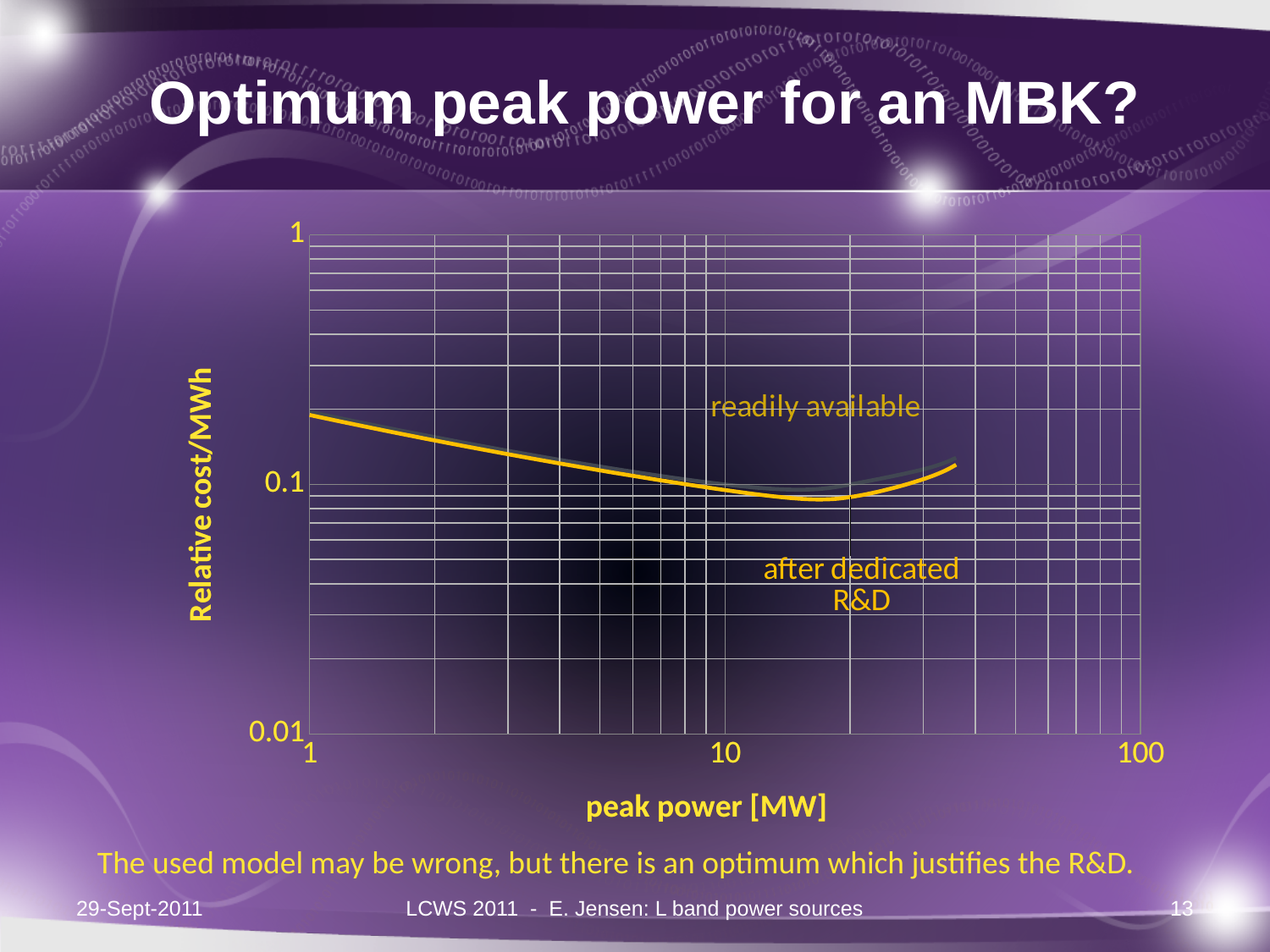
What is the highest value shown on the x axis of the chart? 100 What kind of chart is shown on the slide? line chart Is the relative cost/MWh of the 'readily available' curve at a peak power of 1 MW greater or less than 0.1? greater Is the relative cost/MWh of the 'after dedicated R&D' curve at a peak power of 10 MW greater or less than 0.01? greater How many curves are plotted on the chart? 2 What is the title of the chart on the slide? Optimum peak power for an MBK? Which curve has the lower relative cost/MWh at a peak power of around 20 MW, 'readily available' or 'after dedicated R&D'? after dedicated R&D Does the 'after dedicated R&D' curve rise or fall as peak power increases from 1 MW to 10 MW? fall Does the 'readily available' curve rise or fall as peak power increases from 20 MW to 40 MW? rise Is the relative cost/MWh of the 'readily available' curve at a peak power of 1 MW greater or less than 1? less What is the label of the x axis of the chart? peak power [MW]